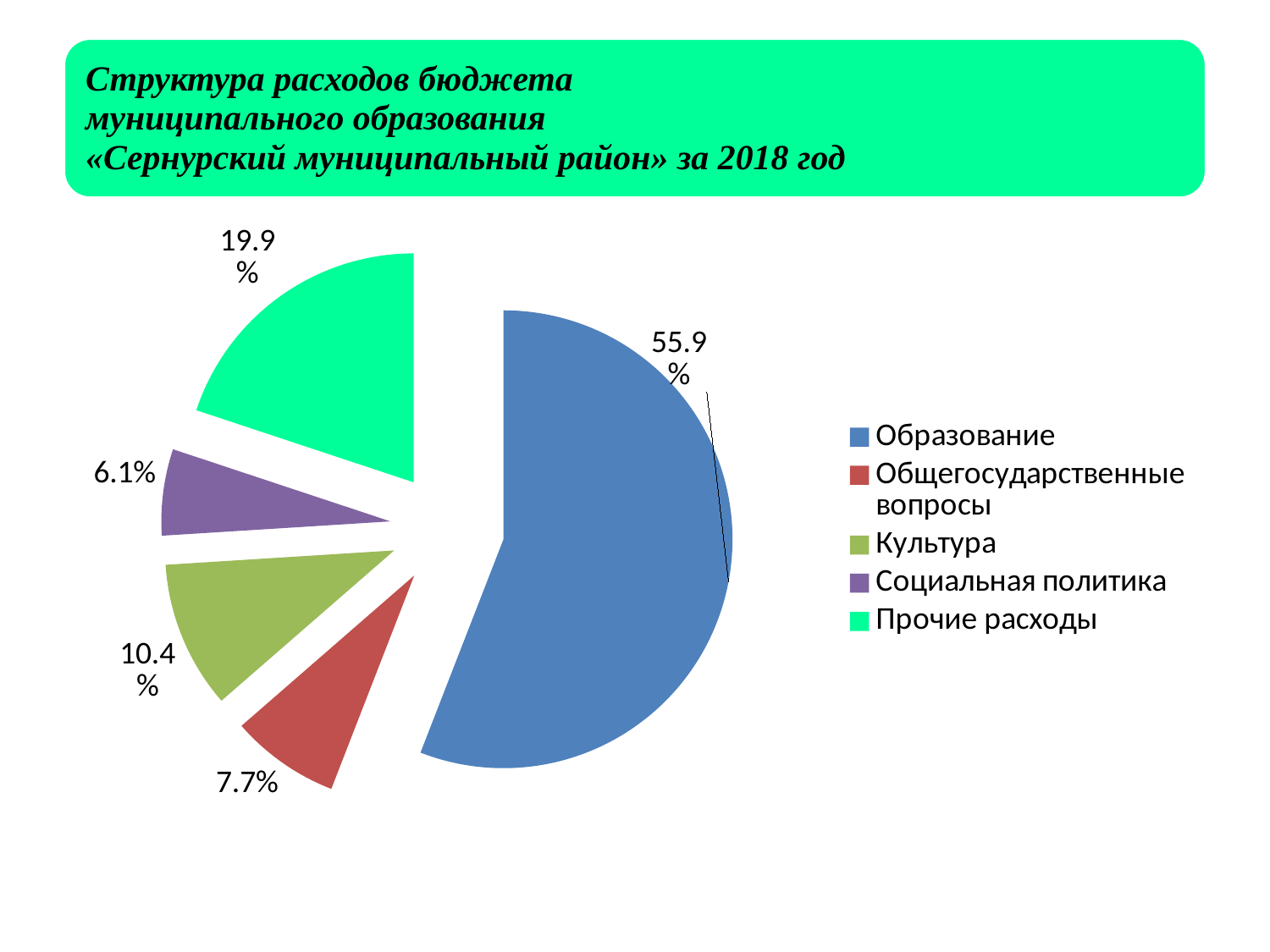
What share of the pie does Образование have? 55.9% Which category has the smallest share of the pie? Социальная политика What is the value shown for Общегосударственные вопросы? 7.7% What is the difference between the shares of Образование and Прочие расходы? 36.0% Which colour is used for the Прочие расходы slice? green Which category has the largest share of the pie? Образование Which is larger, the share for Культура or the share for Общегосударственные вопросы? Культура What is the value shown for Культура? 10.4% What kind of chart is shown on the slide? pie chart What is the value shown for Прочие расходы? 19.9% What is the value shown for Социальная политика? 6.1% How many slices does the pie chart have? 5